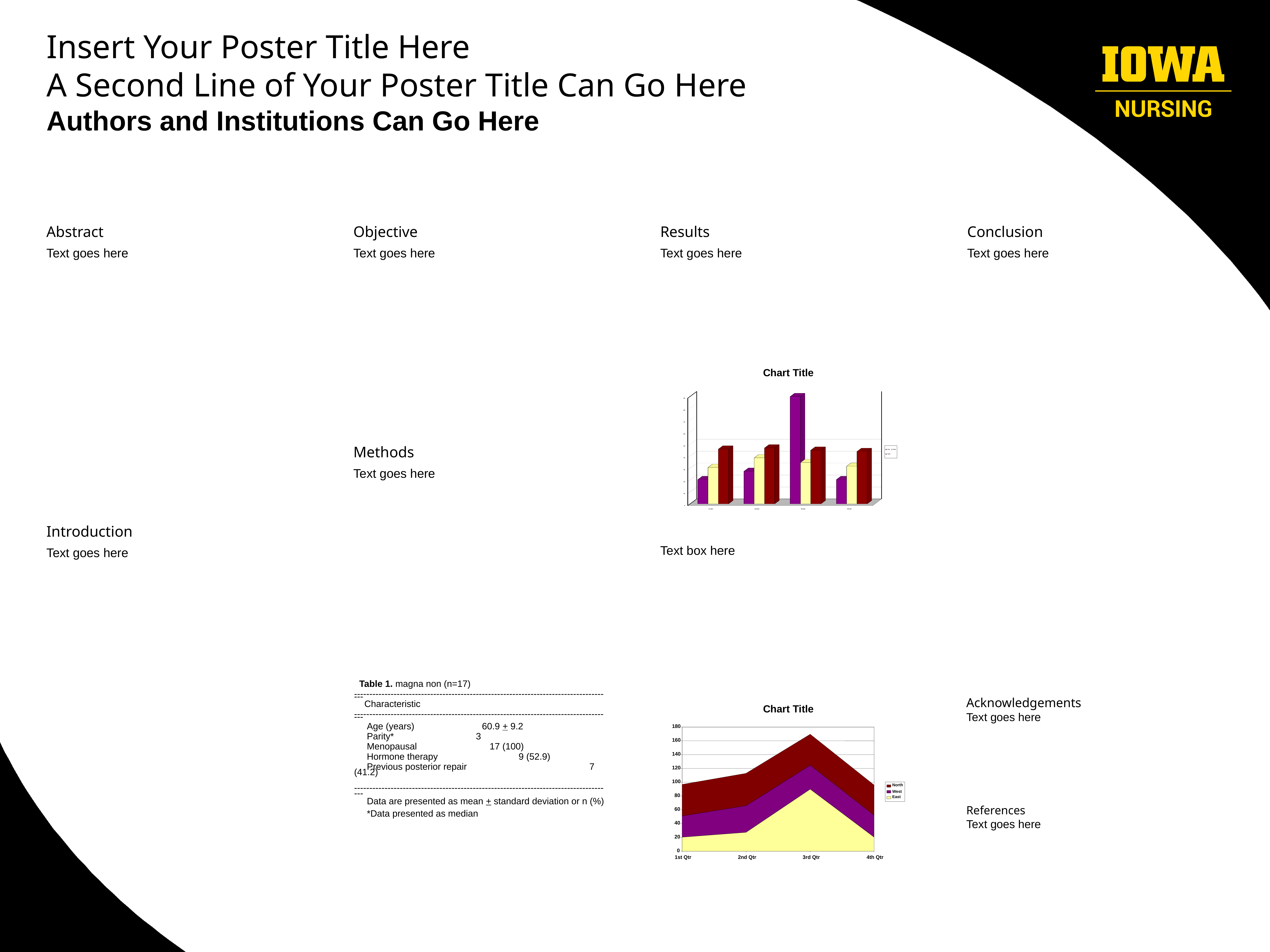
In the bottom chart, is the top of the stacked area at 3rd Qtr greater or less than 140? greater In the bottom chart, which quarter has the highest East value? 3rd Qtr In the bottom chart, do the stacked values rise or fall from 2nd Qtr to 3rd Qtr? rise What kind of chart is the chart at the bottom of the Results column? stacked area chart In the bottom chart, is the East value for 1st Qtr greater or less than 40? less What kind of chart is the chart in the upper part of the Results column? bar chart In the bottom chart, how many series does the legend list? 3 In the top bar chart, how many groups of bars are shown along the x axis? 4 In the bottom chart, is the East value for 3rd Qtr greater or less than 60? greater In the bottom chart, how many categories are shown on the x axis? 4 In the bottom chart, what are the series names listed in the legend? North, West, East